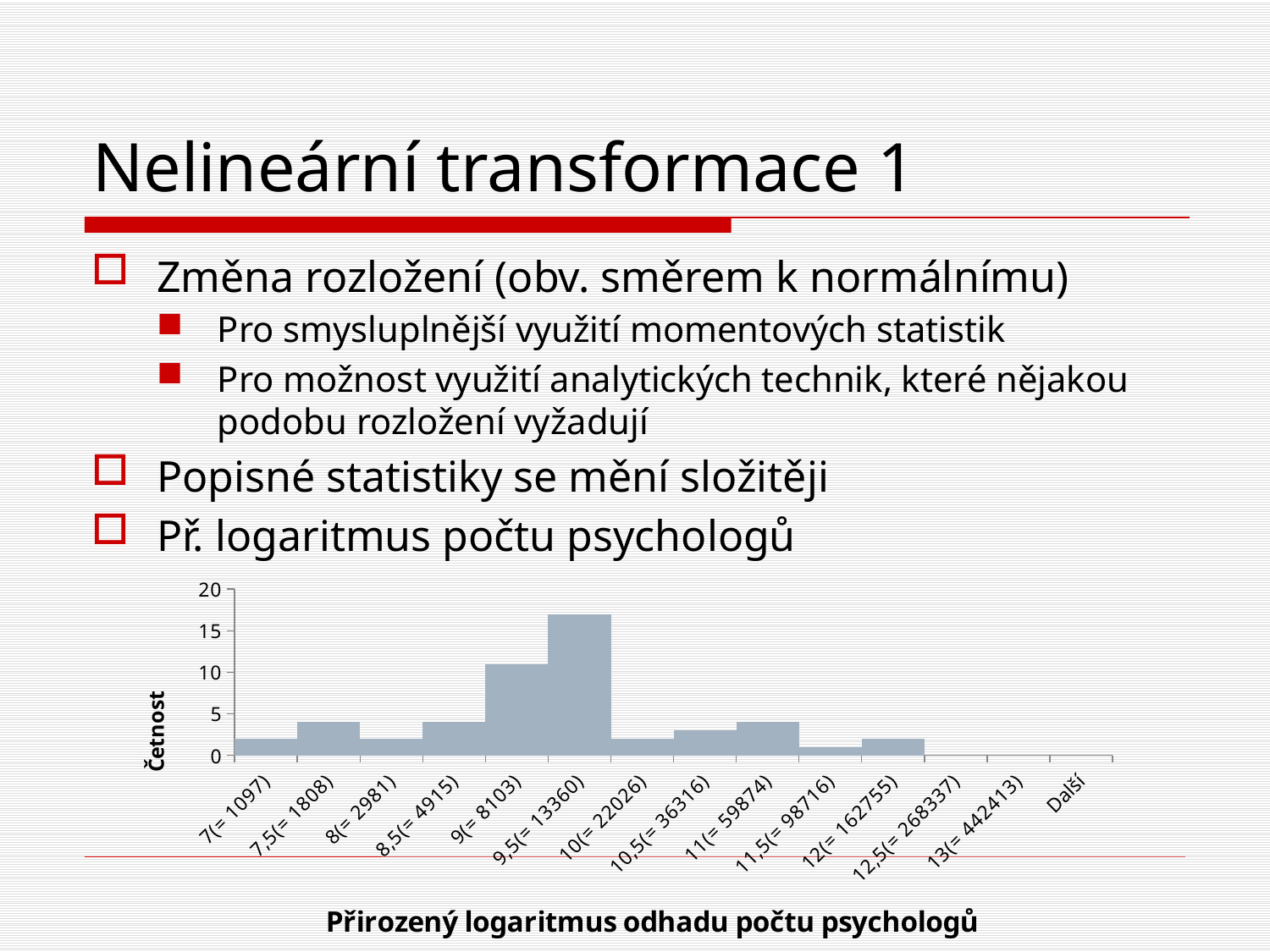
Which is larger, the value for 9,5(= 13360) or the value for 9(= 8103)? 9,5(= 13360) Is the value for 7(= 1097) greater or less than 5? less Which category has the highest frequency (Četnost) in the chart? 9,5(= 13360) Is the value for 9,5(= 13360) greater or less than 15? greater Is the value for 10(= 22026) greater or less than 5? less Which is larger, the value for 9(= 8103) or the value for 10(= 22026)? 9(= 8103) What is the label of the horizontal axis of the chart? Přirozený logaritmus odhadu počtu psychologů What kind of chart is shown on the slide? bar chart How many categories are shown on the x axis of the chart? 14 What is the label of the vertical axis of the chart? Četnost